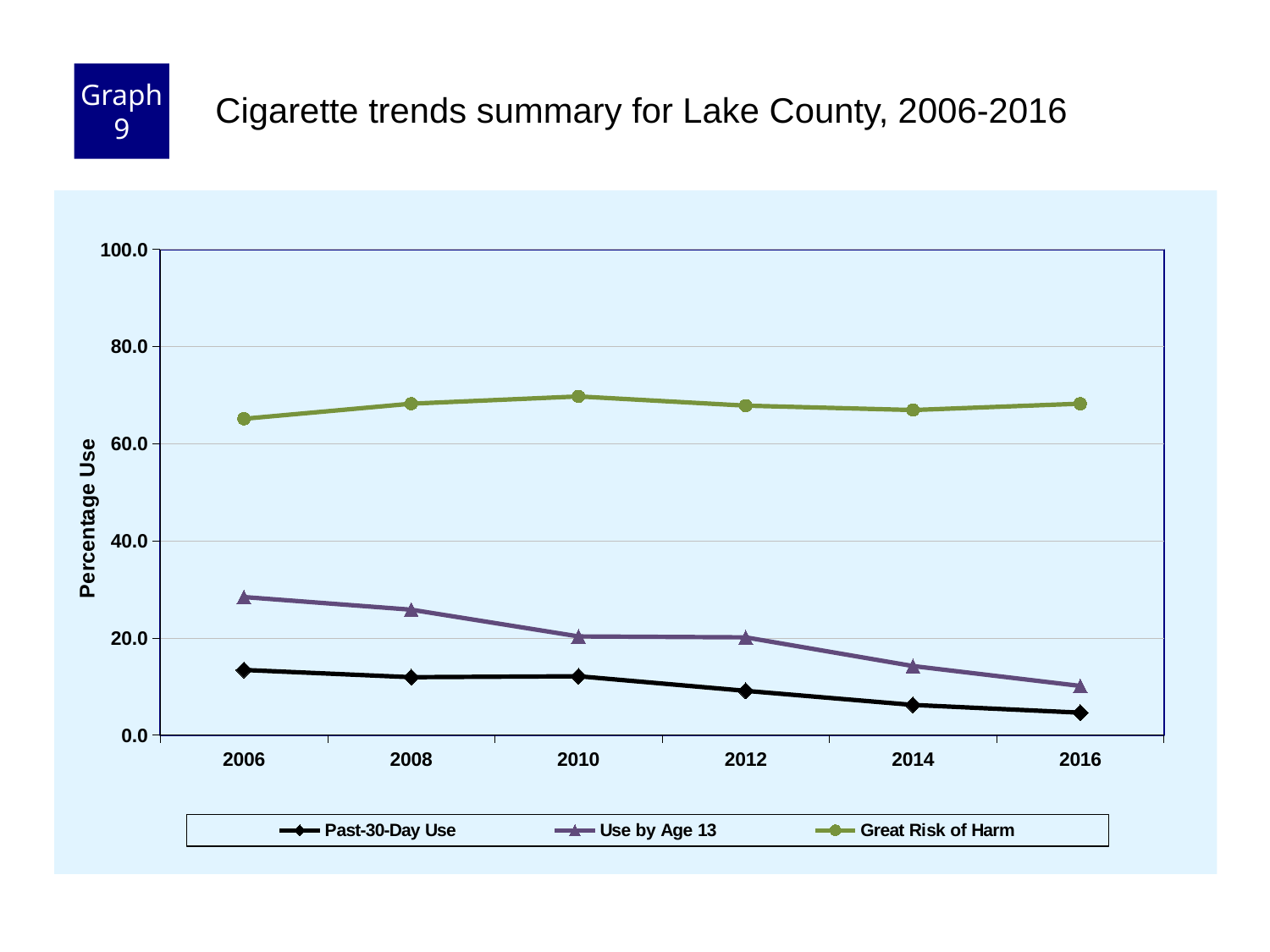
Is the value for Use by Age 13 in 2006 greater or less than 20.0? greater What kind of chart is shown on the slide? line chart In 2012, which is larger: Great Risk of Harm or Past-30-Day Use? Great Risk of Harm In which year is the Past-30-Day Use series lowest? 2016 Does the Past-30-Day Use series rise or fall from 2006 to 2016? fall Is the value for Great Risk of Harm in 2010 greater or less than 60.0? greater How many series does the legend list? 3 In which year is the Use by Age 13 series highest? 2006 What is the label on the y axis? Percentage Use How many years are plotted along the x axis? 6 Does the Use by Age 13 series rise or fall from 2006 to 2016? fall Is the value for Past-30-Day Use in 2016 greater or less than 20.0? less